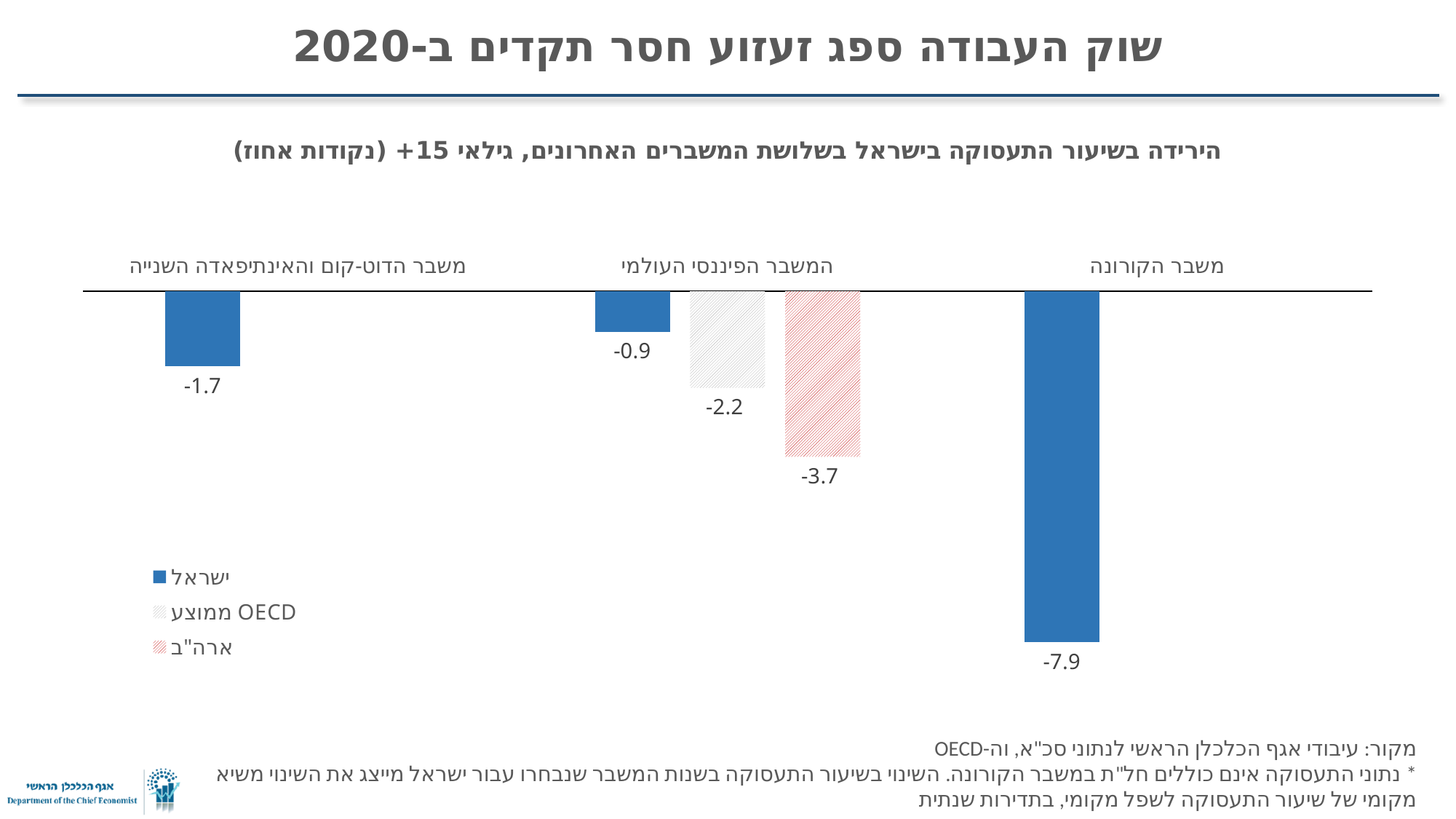
In the המשבר הפיננסי העולמי category, which series has the larger decline: ממוצע OECD or ארה"ב? ארה"ב What is the value for ממוצע OECD in the המשבר הפיננסי העולמי category? -2.2 What kind of chart is shown on the slide? Bar chart How many series does the legend list? 3 What is the value for ישראל in the המשבר הפיננסי העולמי category? -0.9 What is the value for ישראל in the משבר הקורונה category? -7.9 What is the difference between the ישראל value for משבר הקורונה and the ישראל value for משבר הדוט-קום והאינתיפאדה השנייה? 6.2 How many categories are shown on the x axis? 3 What is the value for ישראל in the משבר הדוט-קום והאינתיפאדה השנייה category? -1.7 In which category does ישראל have the lowest (most negative) value? משבר הקורונה What is the value for ארה"ב in the המשבר הפיננסי העולמי category? -3.7 In which category does ישראל have the highest (least negative) value? המשבר הפיננסי העולמי